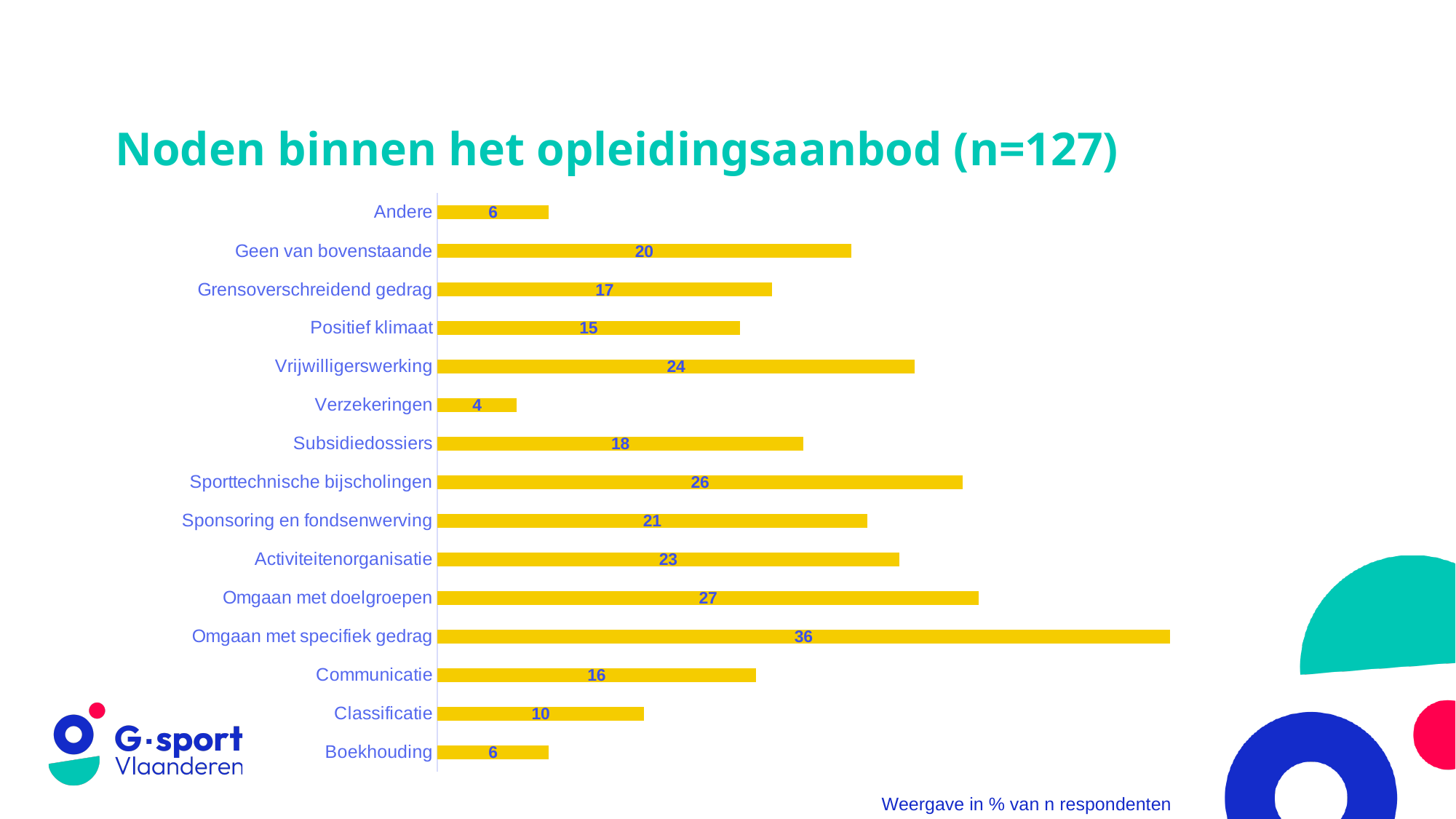
What is the value for Omgaan met specifiek gedrag? 36 What is the value for Vrijwilligerswerking? 24 Which category has the highest value? Omgaan met specifiek gedrag What is the difference between the values for Sporttechnische bijscholingen and Subsidiedossiers? 8 What kind of chart is shown on the slide? Bar chart What is the title of the chart? Noden binnen het opleidingsaanbod (n=127) Which is larger, the value for Activiteitenorganisatie or the value for Sponsoring en fondsenwerving? Activiteitenorganisatie How many categories are shown in the chart? 15 Which is larger, the value for Communicatie or the value for Grensoverschreidend gedrag? Grensoverschreidend gedrag Which category has the lowest value? Verzekeringen What is the difference between the values for Omgaan met specifiek gedrag and Omgaan met doelgroepen? 9 What is the value for Classificatie? 10